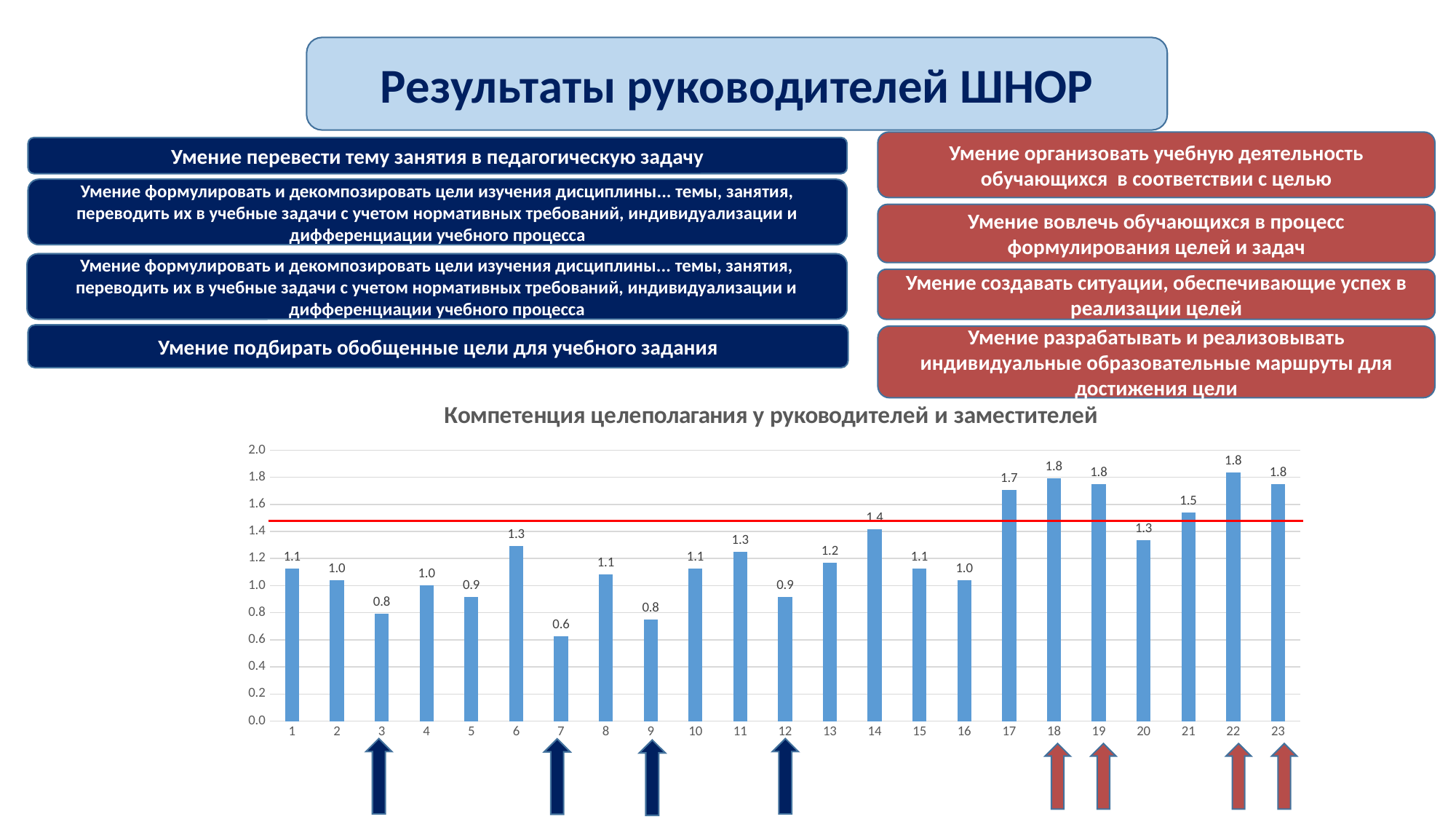
What kind of chart is shown on the slide? bar chart Which has a larger value, category 12 or category 13? category 13 Is the value for category 18 greater or less than 1.6? greater What is the value for category 7 in the chart? 0.6 What is the difference between the values for category 17 and category 7? 1.1 What is the difference between the values for category 21 and category 3? 0.7 What is the value for category 14 in the chart? 1.4 How many categories are shown on the x axis of the chart? 23 Which has a larger value, category 6 or category 3? category 6 Which category has the lowest value in the chart? 7 What is the title of the chart? Компетенция целеполагания у руководителей и заместителей What is the value for category 17 in the chart? 1.7